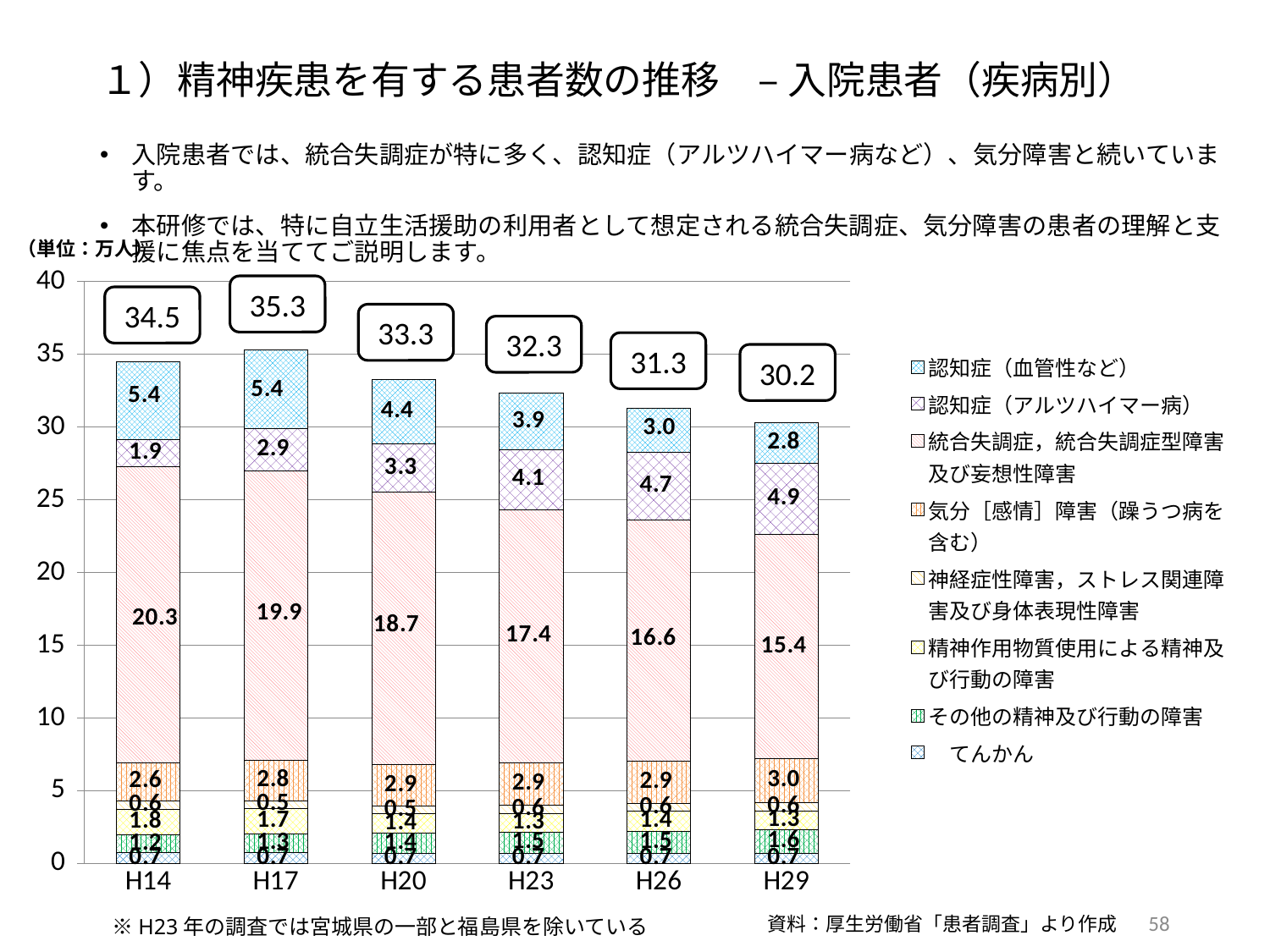
How many years (categories) are shown on the x axis? 6 Which year has the highest total number of inpatients? H17 Which year has the lowest value for 統合失調症，統合失調症型障害及び妄想性障害? H29 What is the value for 認知症（アルツハイマー病） in H26? 4.7 What is the total number of inpatients (万人) shown above the bar for H29? 30.2 What is the value for 統合失調症，統合失調症型障害及び妄想性障害 in H14? 20.3 What is the value for 認知症（血管性など） in H20? 4.4 What is the difference between the 統合失調症，統合失調症型障害及び妄想性障害 values for H14 and H29? 4.9 What is the total number of inpatients (万人) shown above the bar for H17? 35.3 Does the value for 認知症（アルツハイマー病） rise or fall from H14 to H29? rise What kind of chart is shown on the slide? stacked bar chart How many series does the legend list? 8